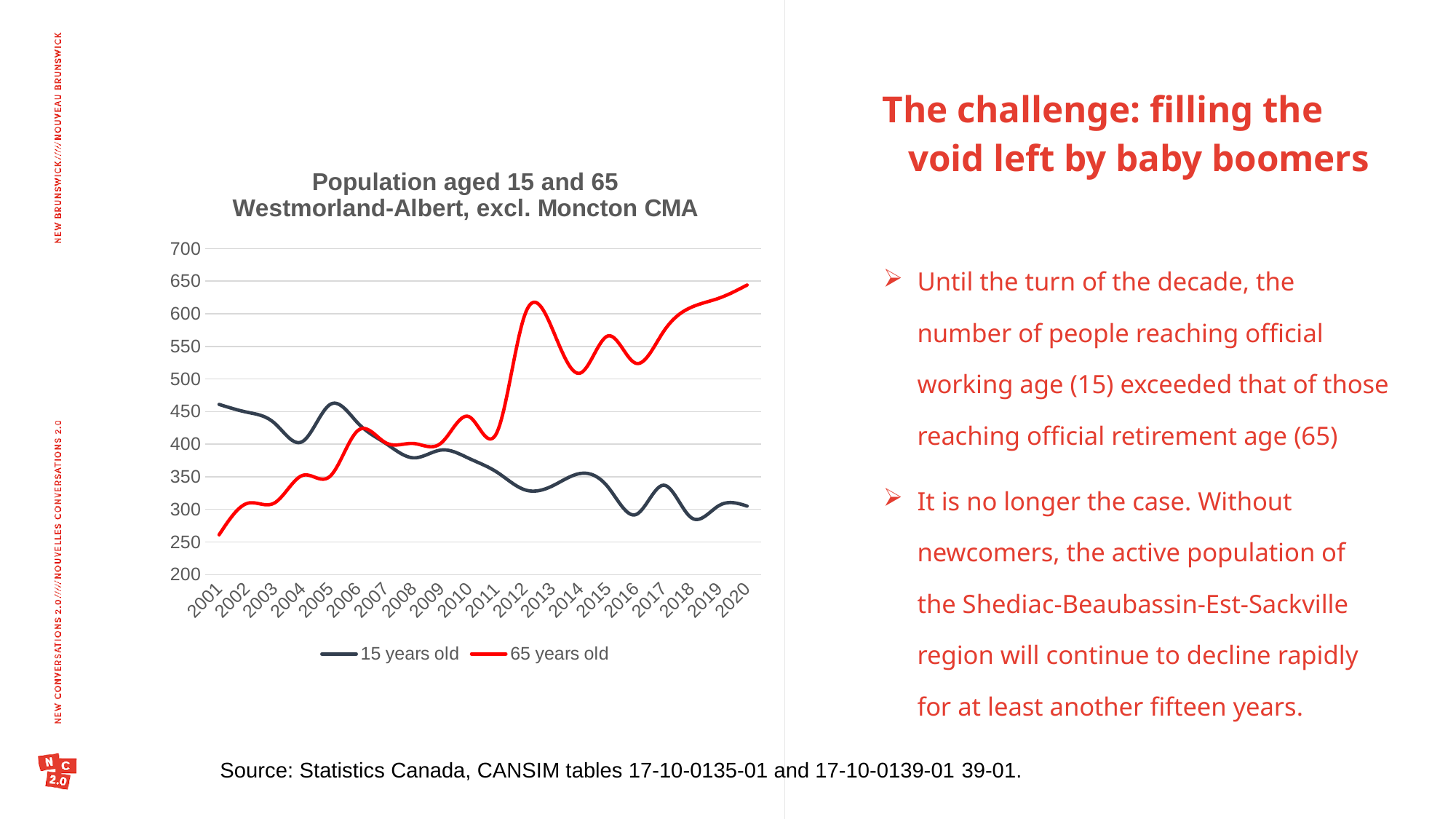
Does the 65 years old line generally rise or fall from 2001 to 2020? rise In which year is the 65 years old series at its highest? 2020 In 2001, which series has the larger value, 15 years old or 65 years old? 15 years old How many years are plotted along the x axis? 20 Is the value for 15 years old in 2020 greater or less than 350? less Is the value for 65 years old in 2001 greater or less than 300? less In which year is the 65 years old series at its lowest? 2001 How many series does the legend list? 2 In 2020, which series has the larger value, 15 years old or 65 years old? 65 years old Does the 15 years old line generally rise or fall from 2001 to 2020? fall Is the value for 65 years old in 2020 greater or less than 600? greater What kind of chart is shown on the slide? line chart